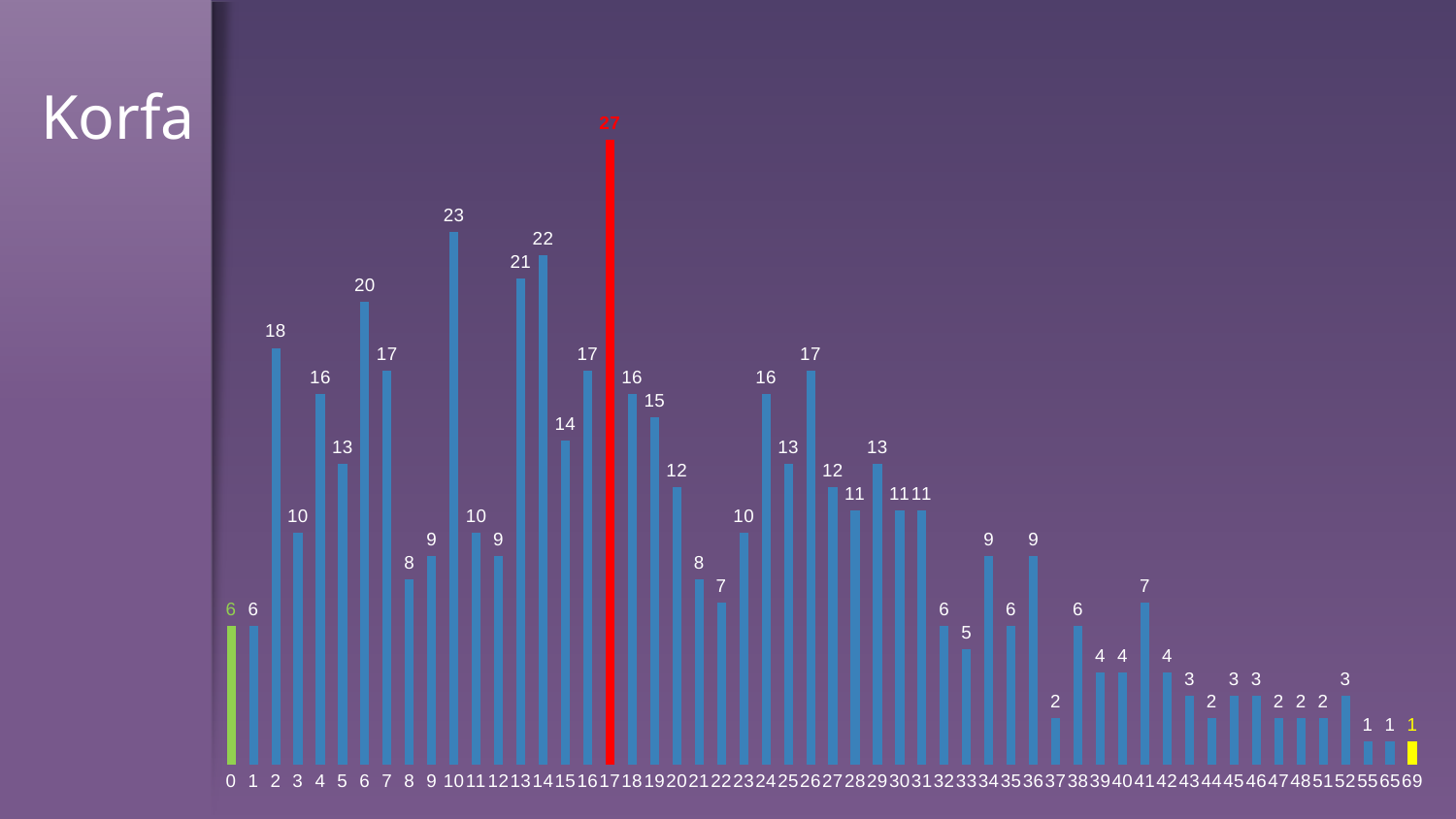
Which category has the highest value? 17 What is the value for category 10? 23 What is the difference between the values for category 14 and category 13? 1 What is the title of the chart? Korfa What is the difference between the values for category 17 and category 10? 4 Which is larger, the value for category 41 or the value for category 38? category 41 Which is larger, the value for category 6 or the value for category 2? category 6 What is the value for category 69? 1 What is the lowest value shown in the chart? 1 What is the value for category 26? 17 What is the value for category 17? 27 What kind of chart is shown on the slide? bar chart